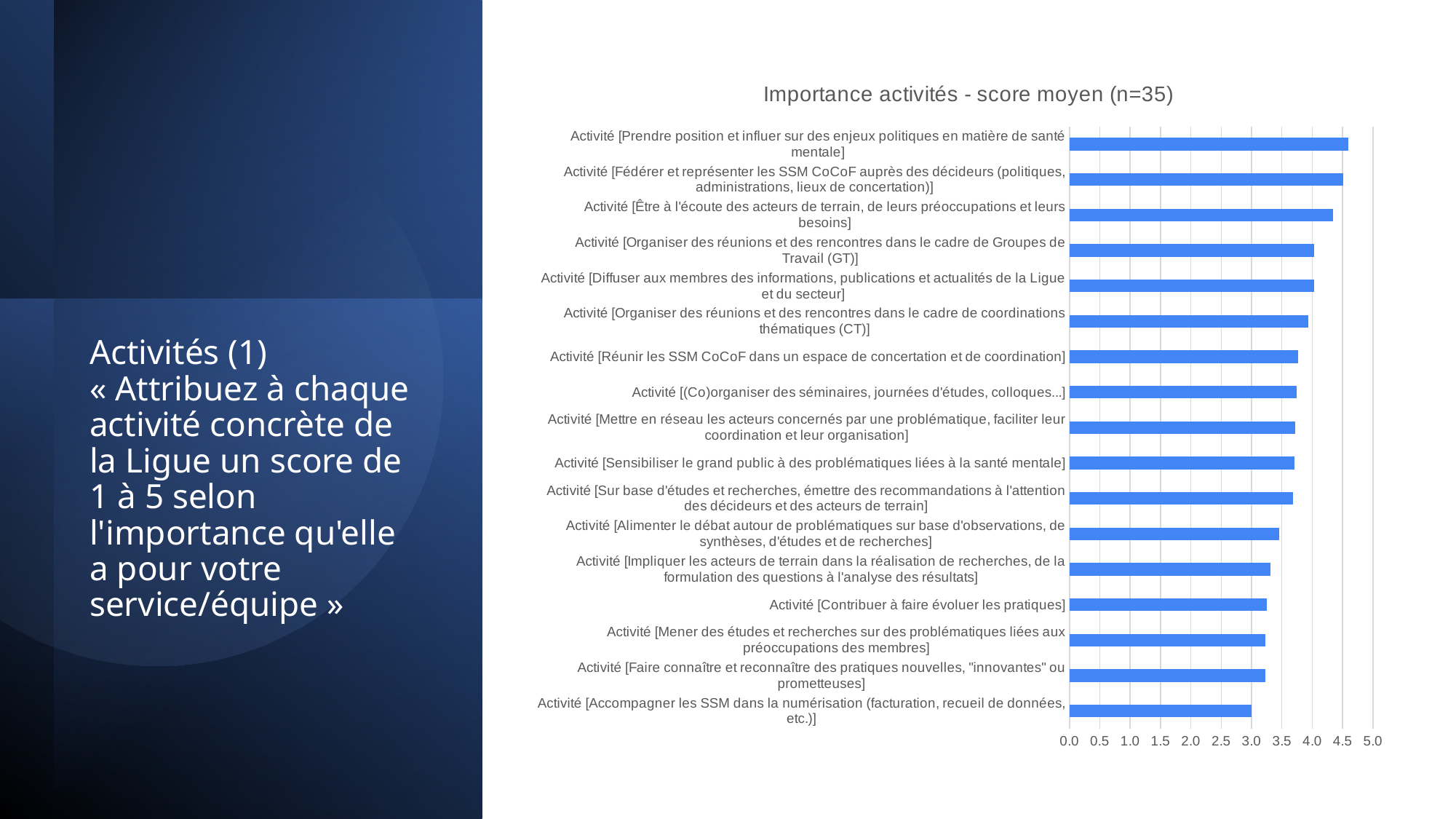
Which has a higher score: "Activité [Être à l'écoute des acteurs de terrain, de leurs préoccupations et leurs besoins]" or "Activité [Accompagner les SSM dans la numérisation (facturation, recueil de données, etc.)]"? Activité [Être à l'écoute des acteurs de terrain, de leurs préoccupations et leurs besoins] Do the bar values increase or decrease going from the top of the chart to the bottom? decrease Is the value for "Activité [Impliquer les acteurs de terrain dans la réalisation de recherches, de la formulation des questions à l'analyse des résultats]" greater or less than 3.0? greater Which has a higher score: "Activité [Sensibiliser le grand public à des problématiques liées à la santé mentale]" or "Activité [Prendre position et influer sur des enjeux politiques en matière de santé mentale]"? Activité [Prendre position et influer sur des enjeux politiques en matière de santé mentale] Is the value for "Activité [Être à l'écoute des acteurs de terrain, de leurs préoccupations et leurs besoins]" greater or less than 4.0? greater What kind of chart is shown on the slide? bar chart How many activities (categories) are plotted in the chart? 17 Is the value for "Activité [Accompagner les SSM dans la numérisation (facturation, recueil de données, etc.)]" greater or less than 3.5? less What is the title of the chart? Importance activités - score moyen (n=35) Which activity has the lowest average importance score? Activité [Accompagner les SSM dans la numérisation (facturation, recueil de données, etc.)]